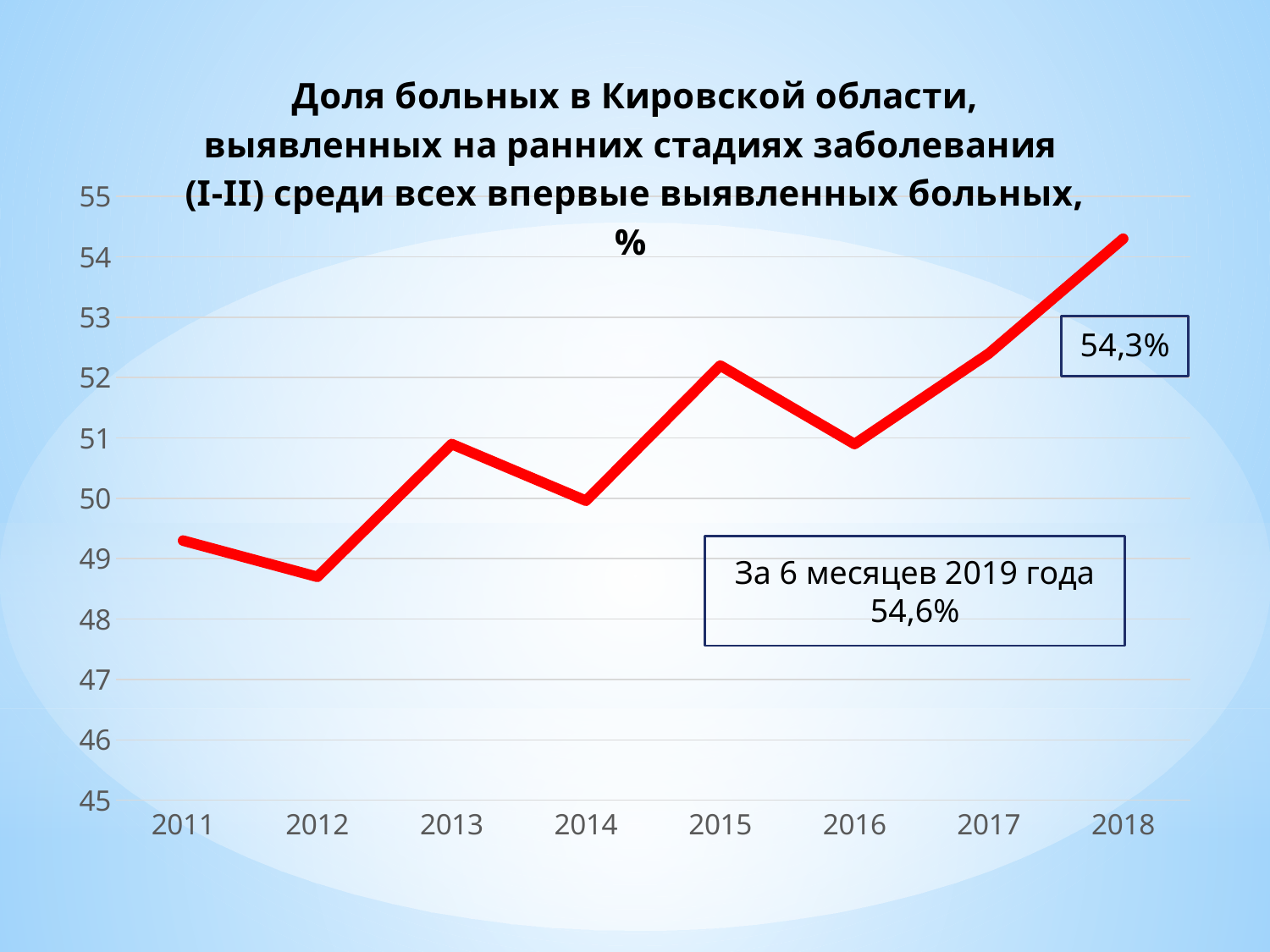
Is the value for 2012 greater or less than 49? less Is the value for 2013 greater or less than 50? greater What kind of chart is shown on the slide? line chart What value does the text box give for the first 6 months of 2019? 54,6% Which year has the lowest value on the chart? 2012 Which is larger, the value for 2015 or the value for 2014? 2015 Is the value for 2017 greater or less than 52? greater Which year has the highest value on the chart? 2018 Which is larger, the value for 2016 or the value for 2017? 2017 What value is labelled for 2018? 54,3% Overall, do the values rise or fall from 2011 to 2018? rise How many years are plotted along the x axis? 8